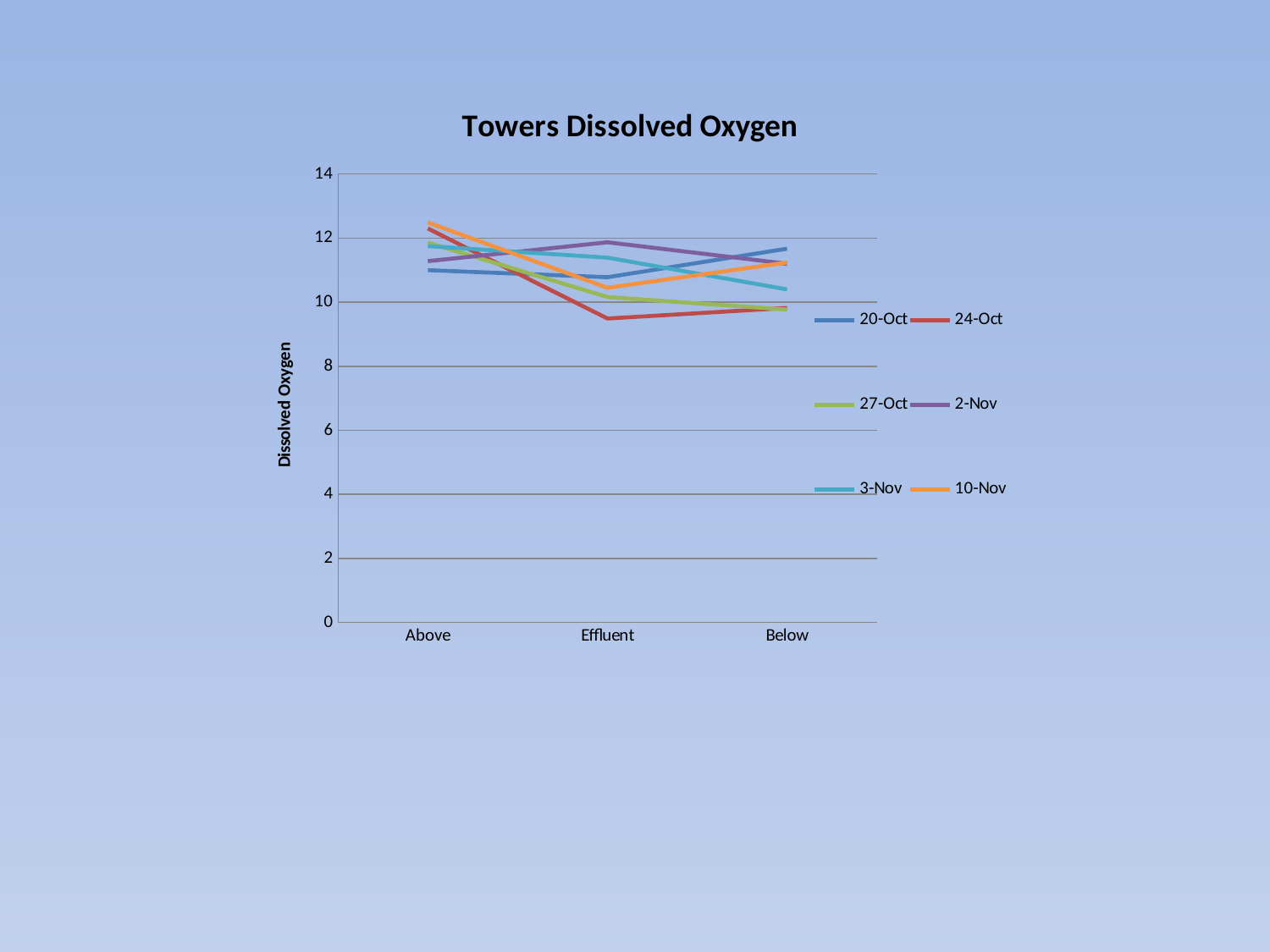
What is the title of the chart? Towers Dissolved Oxygen Is the value for 10-Nov at Above greater or less than 12? greater Does the 24-Oct series rise or fall from Above to Effluent? fall Is the value for 2-Nov at Effluent greater or less than 10? greater How many series does the legend list? 6 Which series has the highest value at Effluent? 2-Nov What kind of chart is shown on the slide? line chart Is the value for 24-Oct at Effluent greater or less than 10? less What is the label on the vertical axis? Dissolved Oxygen At Effluent, which is larger: the value for 24-Oct or the value for 2-Nov? 2-Nov Which series has the lowest value at Effluent? 24-Oct How many categories are shown on the x axis? 3